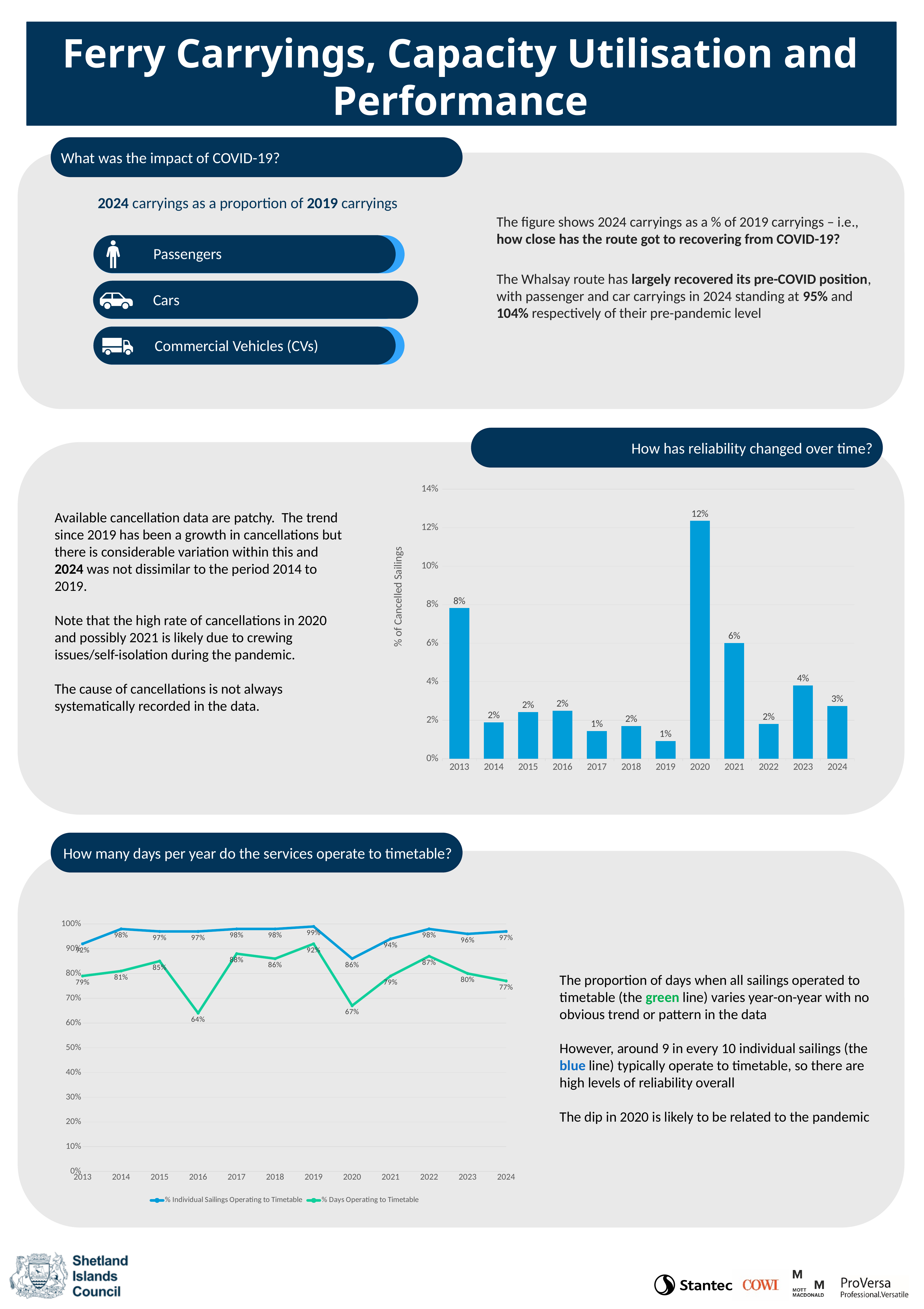
In the bar chart of % of cancelled sailings, is the value for 2023 greater or less than 2%? greater In the line chart at the bottom of the slide, what is the % Individual Sailings Operating to Timetable value for 2019? 99% How many series does the legend of the line chart at the bottom of the slide list? 2 In the bar chart of % of cancelled sailings, which year has the highest value? 2020 In the bar chart of % of cancelled sailings, what is the value for 2020? 12% In the bar chart of % of cancelled sailings, what is the value for 2013? 8% In the line chart at the bottom of the slide, which year has the lowest % Individual Sailings Operating to Timetable? 2020 How many years are shown on the x axis of the bar chart of % of cancelled sailings? 12 In the bar chart of % of cancelled sailings, what is the difference between the 2020 and 2021 values? 6% In the line chart at the bottom of the slide, which is larger in 2022: % Individual Sailings Operating to Timetable or % Days Operating to Timetable? % Individual Sailings Operating to Timetable In the line chart at the bottom of the slide, what is the % Days Operating to Timetable value for 2016? 64% What kind of chart is used to show the % of cancelled sailings? bar chart